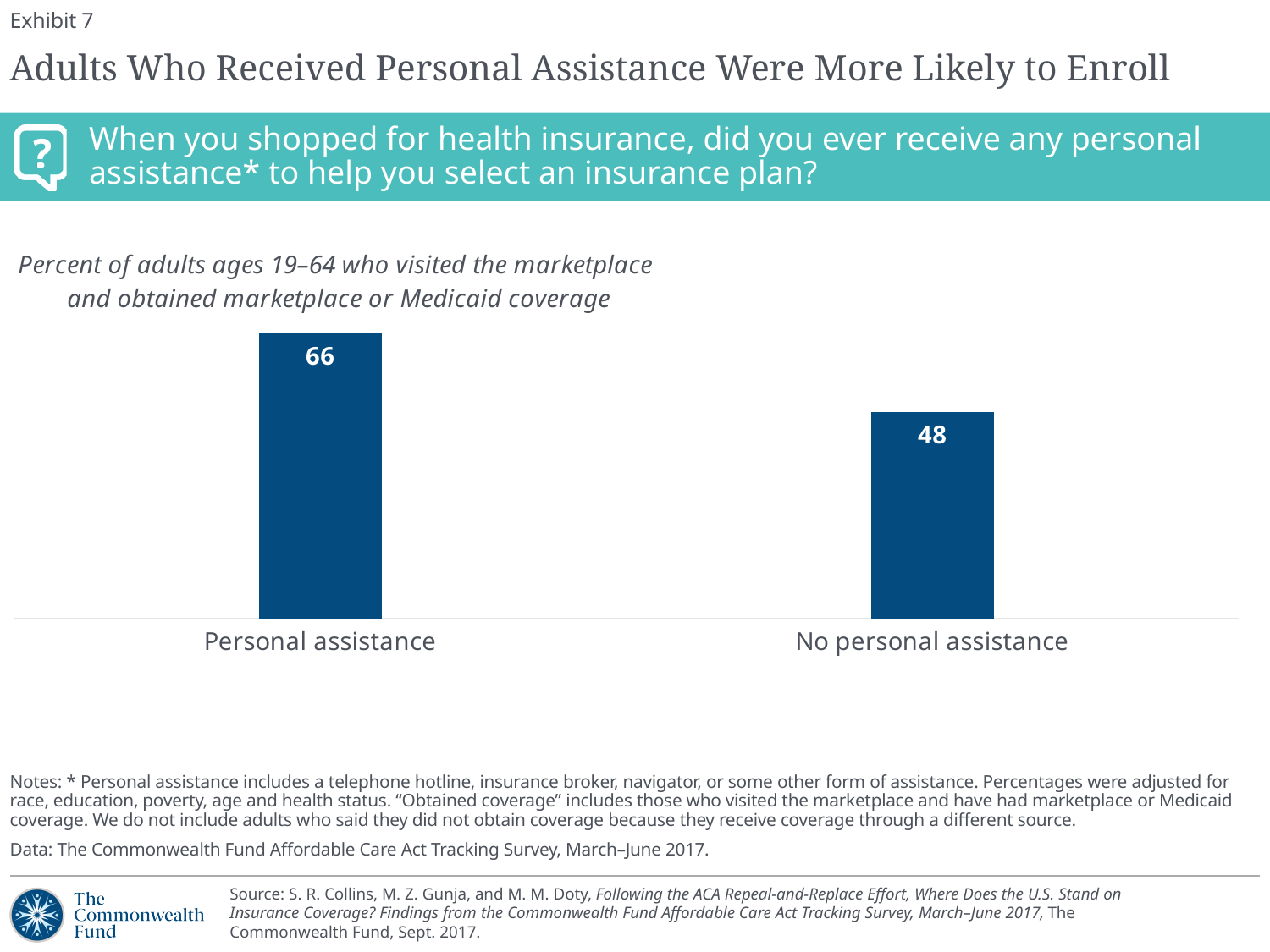
Do the values rise or fall from left to right across the categories? Fall What kind of chart is shown on the slide? Bar chart Which is larger, the value for Personal assistance or the value for No personal assistance? Personal assistance Which category has the lowest value? No personal assistance What is the difference between the values for Personal assistance and No personal assistance? 18 What is the exhibit number of this slide? Exhibit 7 What does the chart's subtitle say the values represent? Percent of adults ages 19–64 who visited the marketplace and obtained marketplace or Medicaid coverage How many categories are shown in the chart? 2 Which category has the highest value? Personal assistance What is the value for No personal assistance? 48 What is the value for Personal assistance? 66